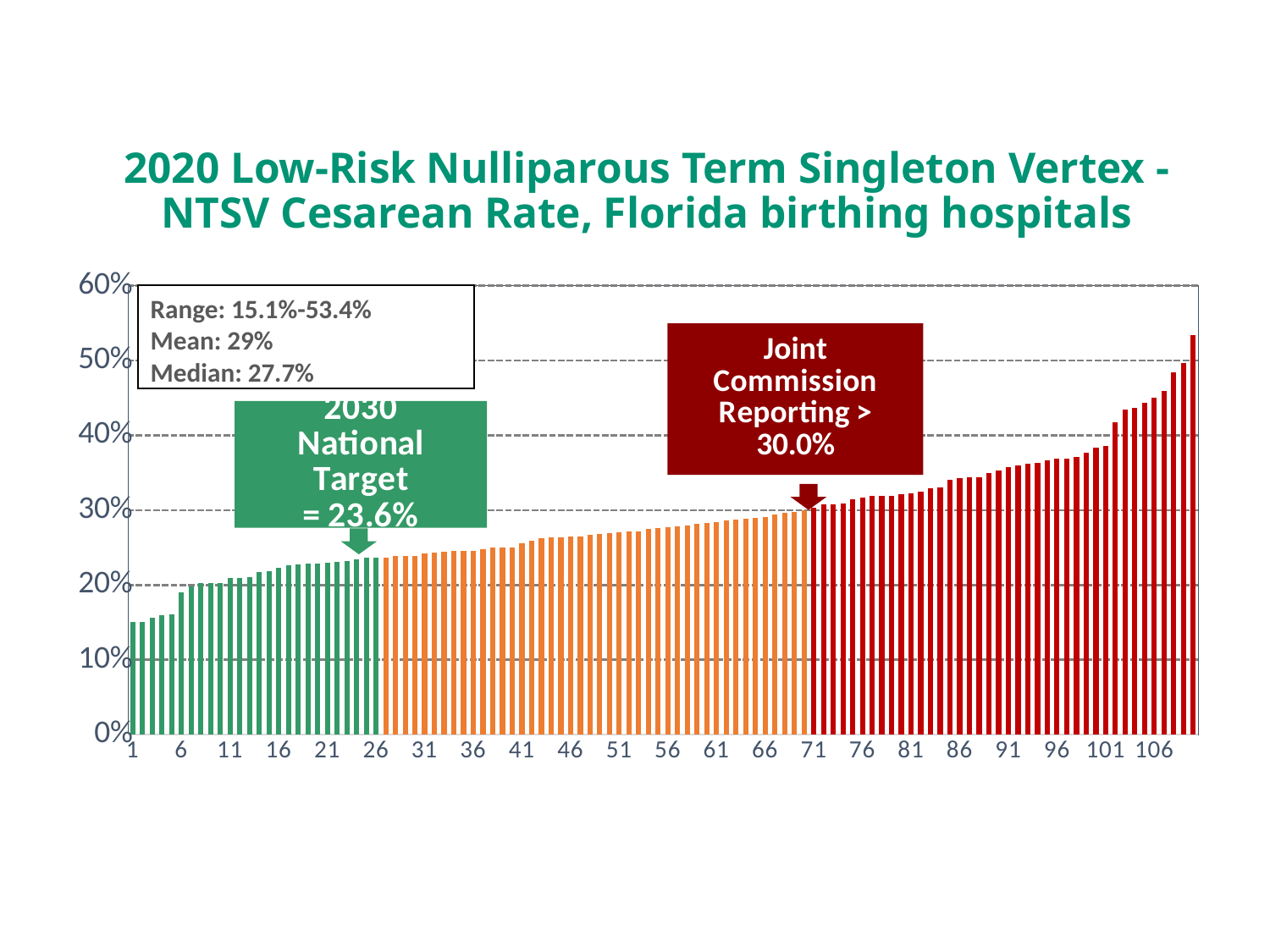
Is the value for hospital 106 greater or less than 40%? greater Which hospital has a higher NTSV cesarean rate, hospital 16 or hospital 96? hospital 96 Is the value for hospital 1 greater or less than 20%? less Do the NTSV cesarean rates rise or fall as you move from hospital 1 to the right along the x axis? rise Is the value for hospital 91 greater or less than 30%? greater What is the 2030 National Target value shown on the chart? 23.6% What range of NTSV cesarean rates is stated in the annotation box on the chart? 15.1%-53.4% What kind of chart is shown on the slide? bar chart Which hospital number has the lowest NTSV cesarean rate? Hospitals 1 and 2 (tied at 15.1%) What is the title of the chart? 2020 Low-Risk Nulliparous Term Singleton Vertex - NTSV Cesarean Rate, Florida birthing hospitals